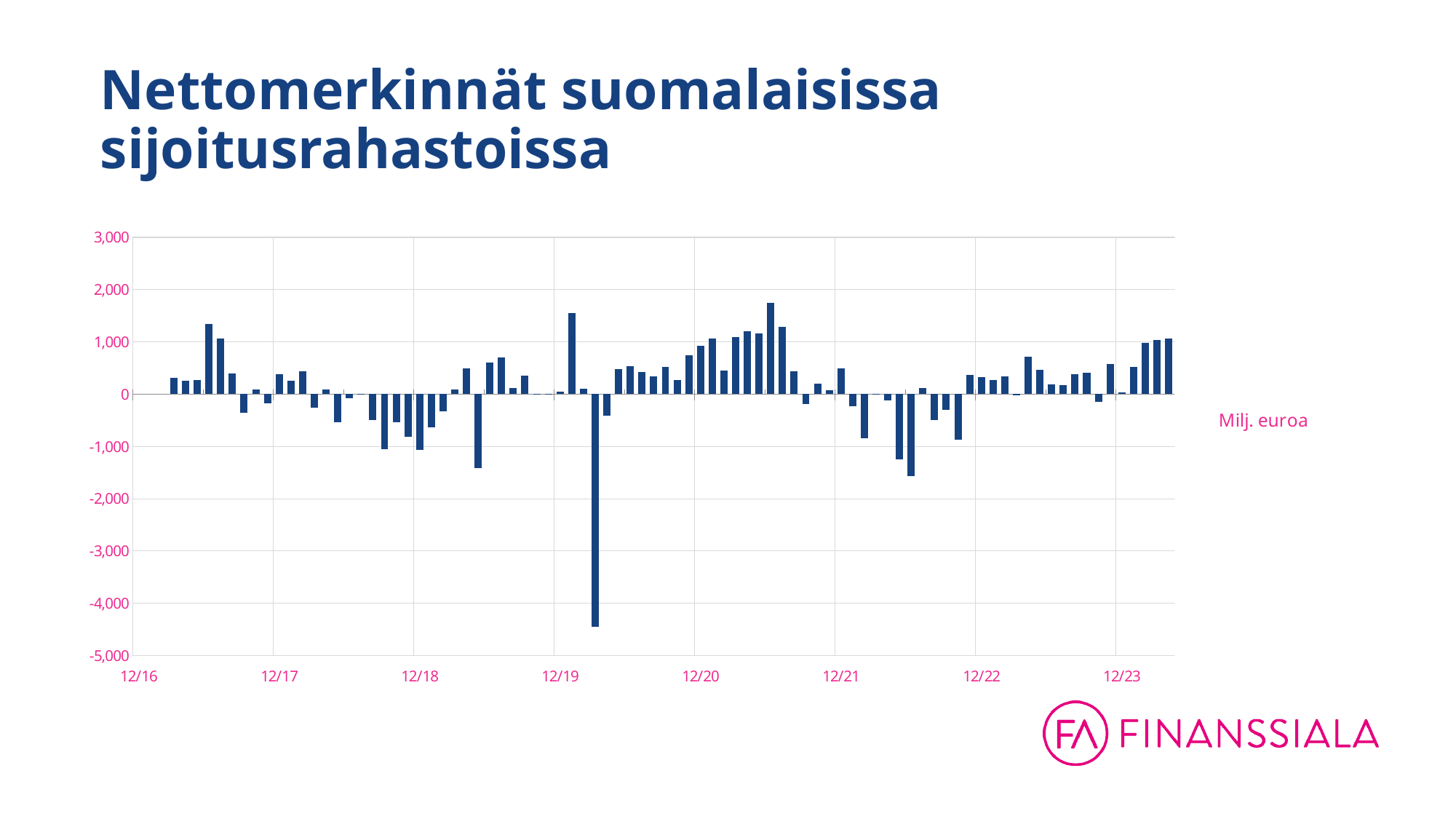
How many date labels are shown on the x axis? 8 Is the value of the highest bar on the chart greater or less than 2,000? less Which is farther from zero, the highest bar or the lowest bar? the lowest bar Do the last bars at the right end of the chart, after 12/23, lie above or below zero? above Between which two x-axis labels does the highest bar on the chart fall? 12/20 and 12/21 Is the value of the lowest bar on the chart greater or less than -4,000? less What kind of chart is shown on the slide? bar chart Between which two x-axis labels does the lowest bar on the chart fall? 12/19 and 12/20 What is the title of the chart? Nettomerkinnät suomalaisissa sijoitusrahastoissa What unit label is shown to the right of the chart? Milj. euroa